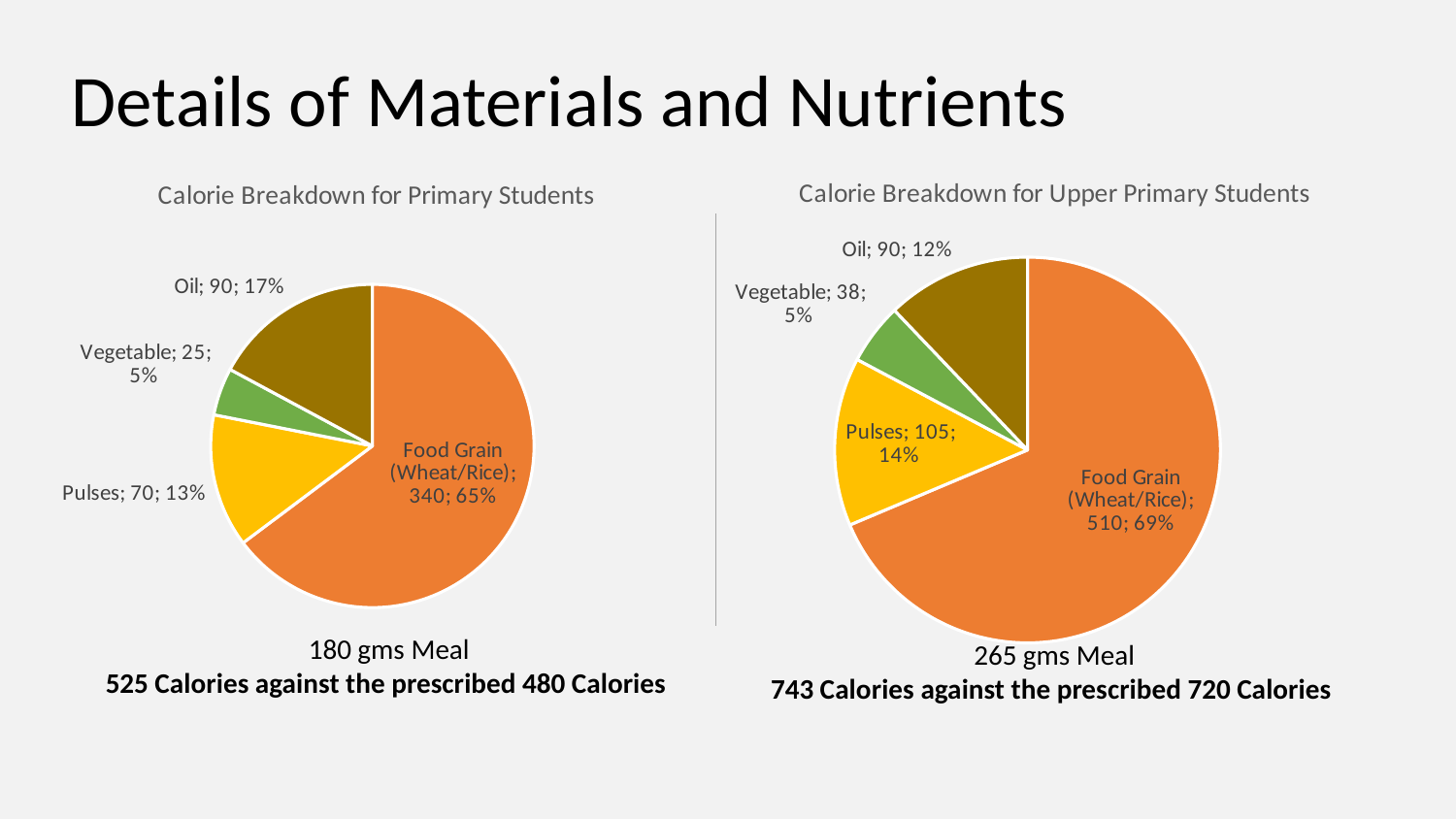
In the 'Calorie Breakdown for Upper Primary Students' chart, what is the difference between the values for Pulses and Oil? 15 In the 'Calorie Breakdown for Primary Students' chart, what share of the pie does Oil represent? 17% What kind of chart is 'Calorie Breakdown for Upper Primary Students'? Pie chart What is the title of the chart on the left side of the slide? Calorie Breakdown for Primary Students In the 'Calorie Breakdown for Upper Primary Students' chart, what is the value for Pulses? 105 In the 'Calorie Breakdown for Upper Primary Students' chart, what share of the pie does Food Grain (Wheat/Rice) represent? 69% In the 'Calorie Breakdown for Upper Primary Students' chart, which category has the largest value? Food Grain (Wheat/Rice) In the 'Calorie Breakdown for Upper Primary Students' chart, which is larger, the value for Oil or the value for Vegetable? Oil In the 'Calorie Breakdown for Primary Students' chart, what is the difference between the values for Oil and Pulses? 20 In the 'Calorie Breakdown for Primary Students' chart, what is the value for Food Grain (Wheat/Rice)? 340 In the 'Calorie Breakdown for Primary Students' chart, which category has the smallest value? Vegetable How many categories does the 'Calorie Breakdown for Primary Students' chart show? 4